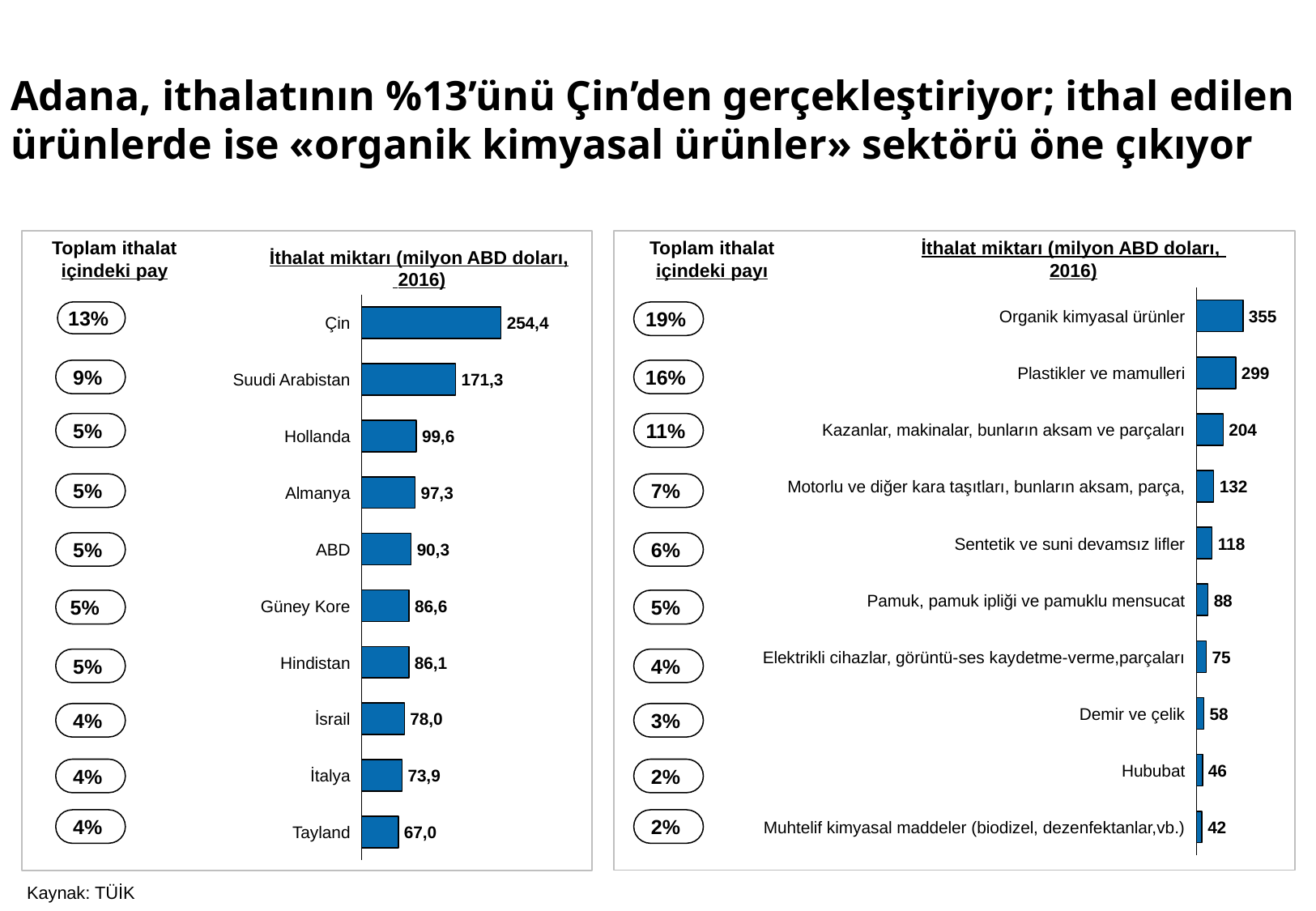
In the right chart (import amounts by product sector), what is the import amount for Plastikler ve mamulleri? 299 In the left chart (import amounts by country), what is the import amount for İsrail? 78,0 In the right chart (import amounts by product sector), which sector has the highest import amount? Organik kimyasal ürünler In the right chart (import amounts by product sector), what share of total imports does Sentetik ve suni devamsız lifler have? 6% In the left chart (import amounts by country), how many countries are shown? 10 In the left chart (import amounts by country), which is larger, the import amount for Hollanda or for Almanya? Hollanda In the right chart (import amounts by product sector), what is the difference between the import amounts for Organik kimyasal ürünler and Hububat? 309 In the left chart (import amounts by country), what is the difference between the import amounts for Çin and Suudi Arabistan? 83,1 What type of chart is the right chart (import amounts by product sector)? Bar chart In the right chart (import amounts by product sector), how many sectors are shown? 10 In the left chart (import amounts by country), what is the import amount for Çin? 254,4 In the left chart (import amounts by country), which country has the lowest import amount? Tayland